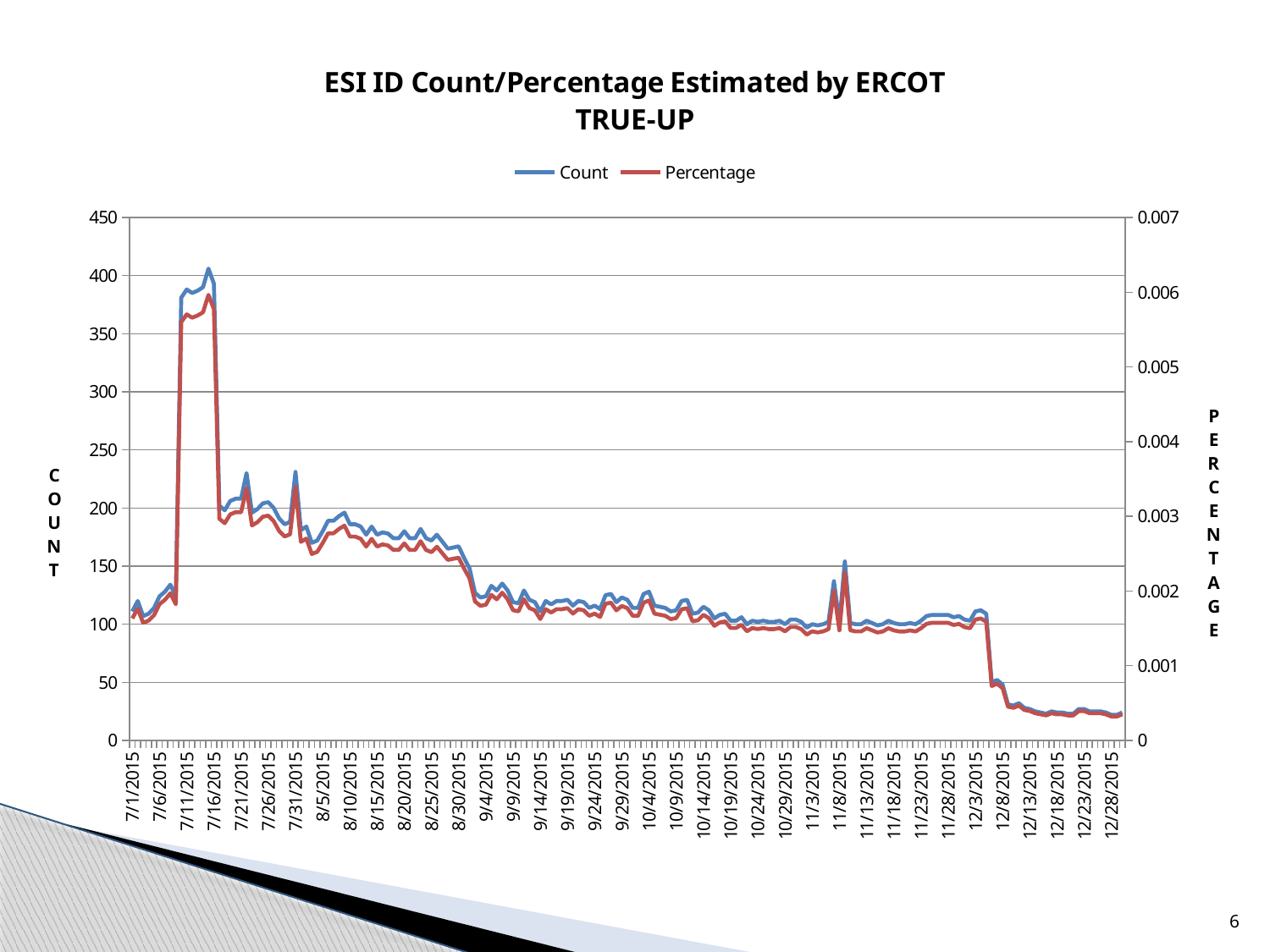
What kind of chart is shown on the slide? line chart Is the Count value on 10/19/2015 greater or less than 150? less How many series does the legend list? 2 What is the title of the chart? ESI ID Count/Percentage Estimated by ERCOT TRUE-UP Is the peak Percentage value in mid-July 2015 greater or less than 0.005? greater Is the Count value on 8/10/2015 greater or less than 150? greater What is the highest value shown on the left (Count) axis? 450 Overall, does the Count series rise or fall from 7/1/2015 to 12/28/2015? fall